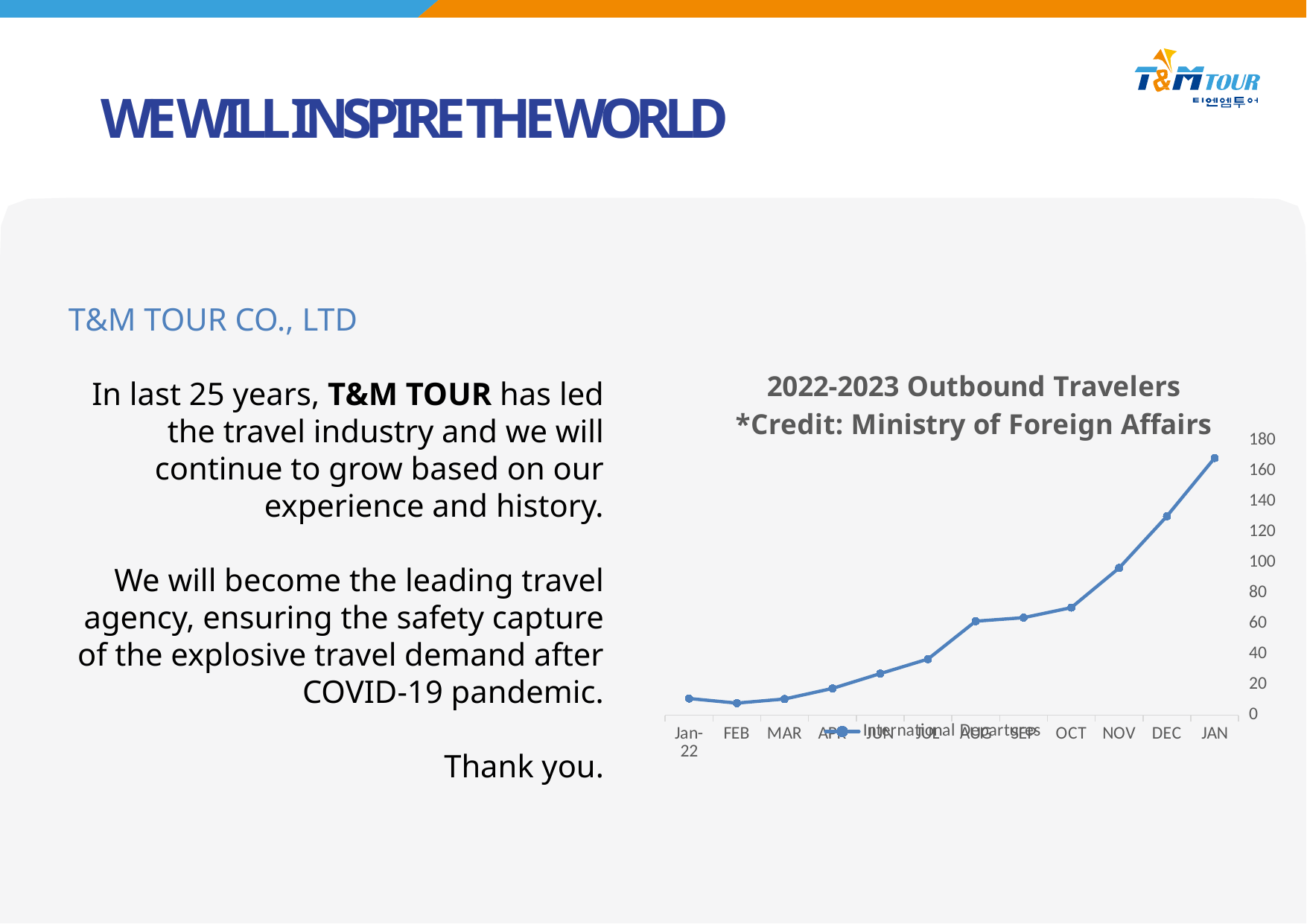
Is the value for OCT greater or less than 80? less What is the title of the chart? 2022-2023 Outbound Travelers *Credit: Ministry of Foreign Affairs Do the values generally rise or fall from Jan-22 to JAN along the x axis? rise Is the value for Jan-22 greater or less than 20? less How many series does the chart's legend list? 1 Which month has the lowest value on the chart? FEB Which is larger, the value for OCT or the value for APR? OCT What kind of chart is shown on the slide? line chart Which month has the highest value on the chart? JAN Is the value for the final JAN point greater or less than 140? greater What is the name of the series shown in the chart legend? International Departures